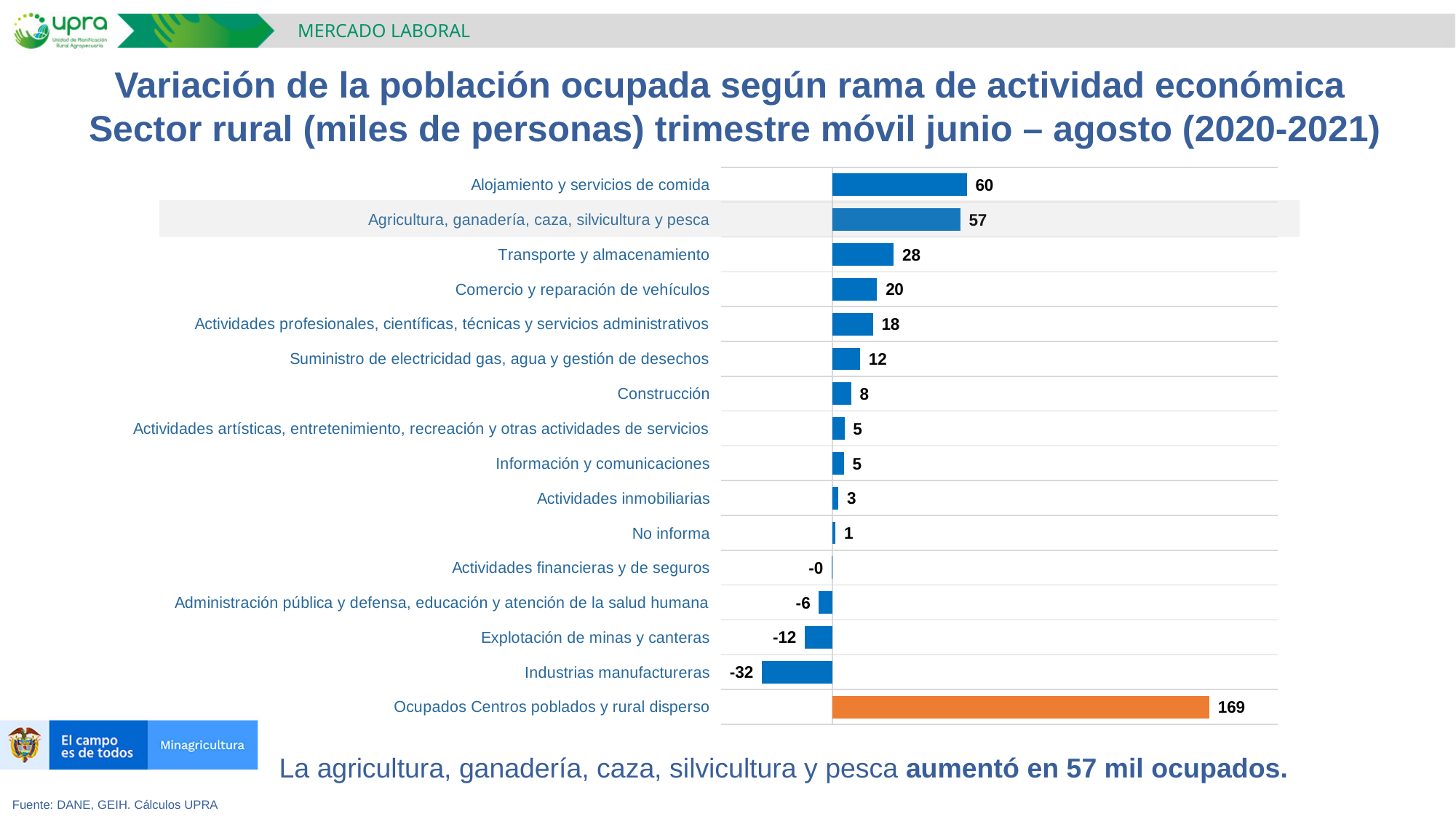
What is the difference between the values for Ocupados Centros poblados y rural disperso and Alojamiento y servicios de comida? 109 What is the value for Alojamiento y servicios de comida? 60 What kind of chart is shown on the slide? Bar chart Which category's bar is coloured orange instead of blue? Ocupados Centros poblados y rural disperso What is the value for Transporte y almacenamiento? 28 What is the value for Industrias manufactureras? -32 Which is larger, the value for Comercio y reparación de vehículos or the value for Suministro de electricidad gas, agua y gestión de desechos? Comercio y reparación de vehículos What is the value for Explotación de minas y canteras? -12 What is the difference between the values for Alojamiento y servicios de comida and Agricultura, ganadería, caza, silvicultura y pesca? 3 Which category has the highest value in the chart? Ocupados Centros poblados y rural disperso How many categories are shown in the chart? 16 Which category has the lowest value in the chart? Industrias manufactureras